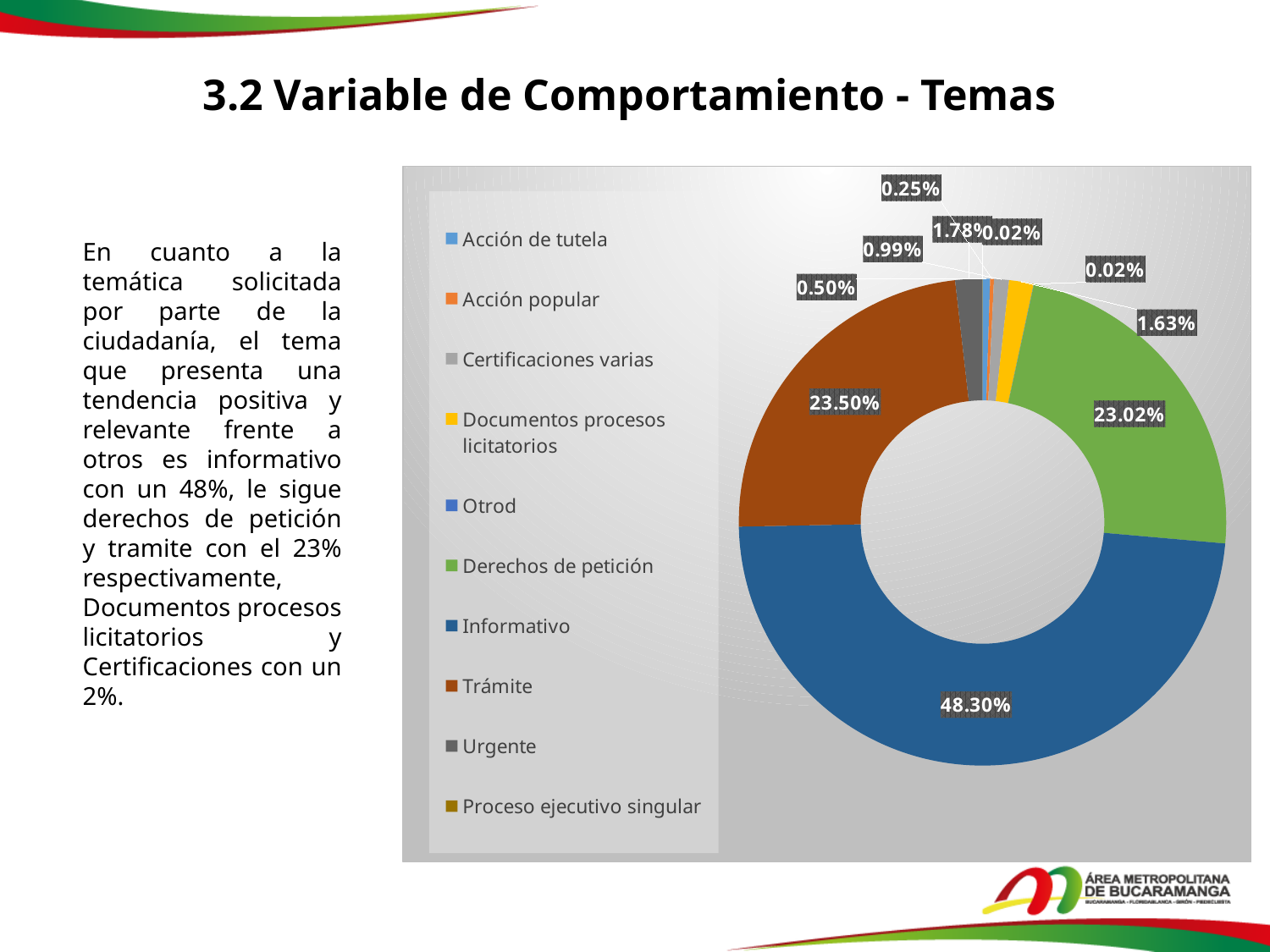
Which is larger, the slice for Trámite or the slice for Derechos de petición? Trámite What is the combined percentage of Informativo, Trámite and Derechos de petición? 94.82% How much larger is the Informativo percentage than the Trámite percentage? 24.80% What share of the chart does Informativo represent? 48.30% How many categories does the legend list? 10 What percentage is shown for Derechos de petición? 23.02% What is the difference between the Trámite and Derechos de petición percentages? 0.48% What kind of chart is shown on the slide? pie (doughnut) chart What percentage is shown for Informativo? 48.30% What colour represents Informativo in the legend? blue What percentage is shown for Trámite? 23.50% Which category has the largest slice of the chart? Informativo